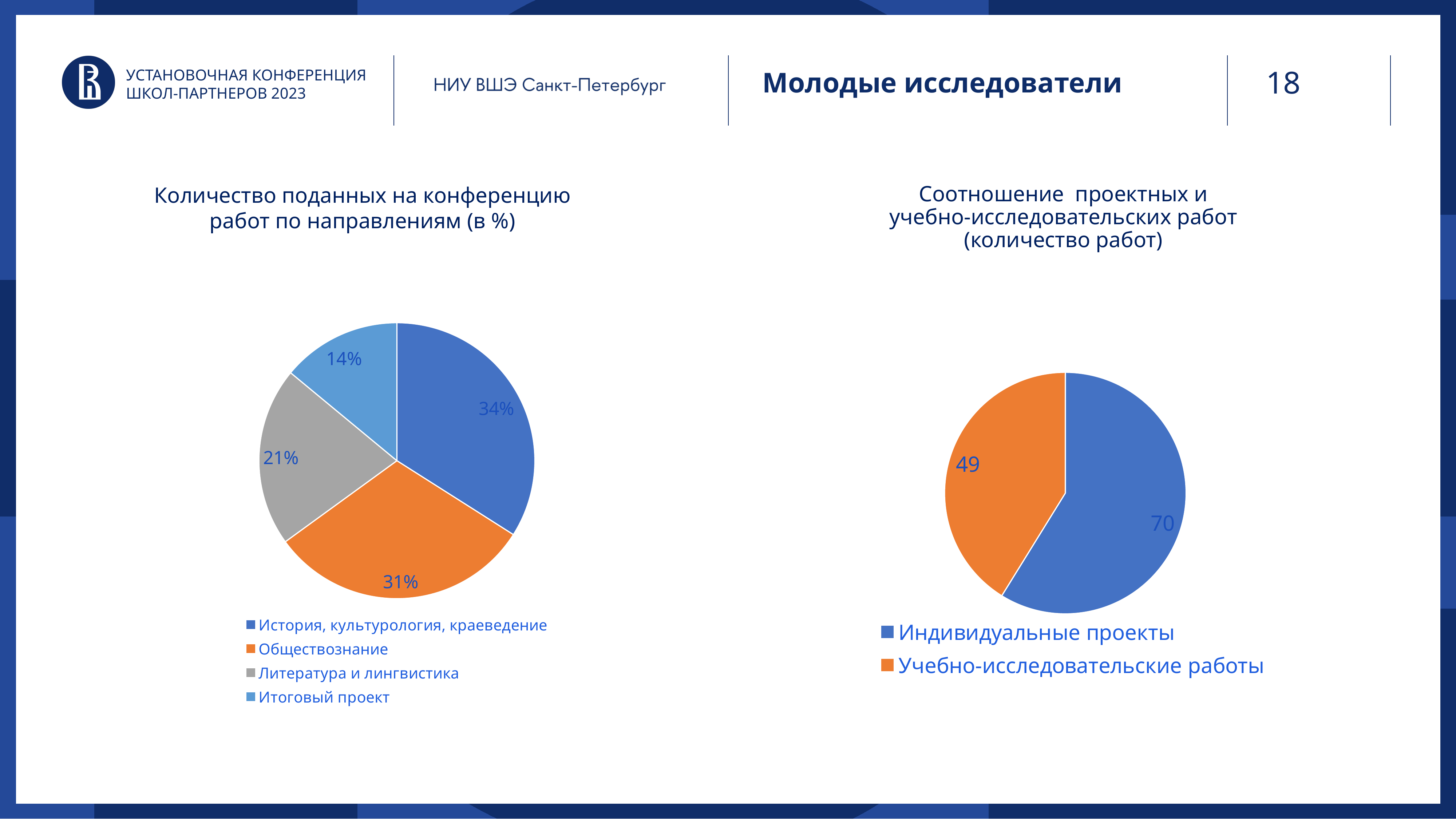
In the right chart (Соотношение проектных и учебно-исследовательских работ), what is the total number of works across both categories? 119 In the right chart (Соотношение проектных и учебно-исследовательских работ), which category is larger: Индивидуальные проекты or Учебно-исследовательские работы? Индивидуальные проекты In the left chart (Количество поданных на конференцию работ по направлениям), what is the value for Литература и лингвистика? 21% In the left chart (Количество поданных на конференцию работ по направлениям), how many categories does the legend list? 4 What type of chart is the right chart (Соотношение проектных и учебно-исследовательских работ)? Pie chart In the left chart (Количество поданных на конференцию работ по направлениям), which category has the largest share? История, культурология, краеведение In the left chart (Количество поданных на конференцию работ по направлениям), what is the difference between Обществознание and Итоговый проект? 17% In the right chart (Соотношение проектных и учебно-исследовательских работ), what is the value for Учебно-исследовательские работы? 49 In the left chart (Количество поданных на конференцию работ по направлениям), what is the value for История, культурология, краеведение? 34% In the left chart (Количество поданных на конференцию работ по направлениям), which category has the smallest share? Итоговый проект In the left chart (Количество поданных на конференцию работ по направлениям), what colour is the slice for Литература и лингвистика? Grey In the right chart (Соотношение проектных и учебно-исследовательских работ), what is the value for Индивидуальные проекты? 70